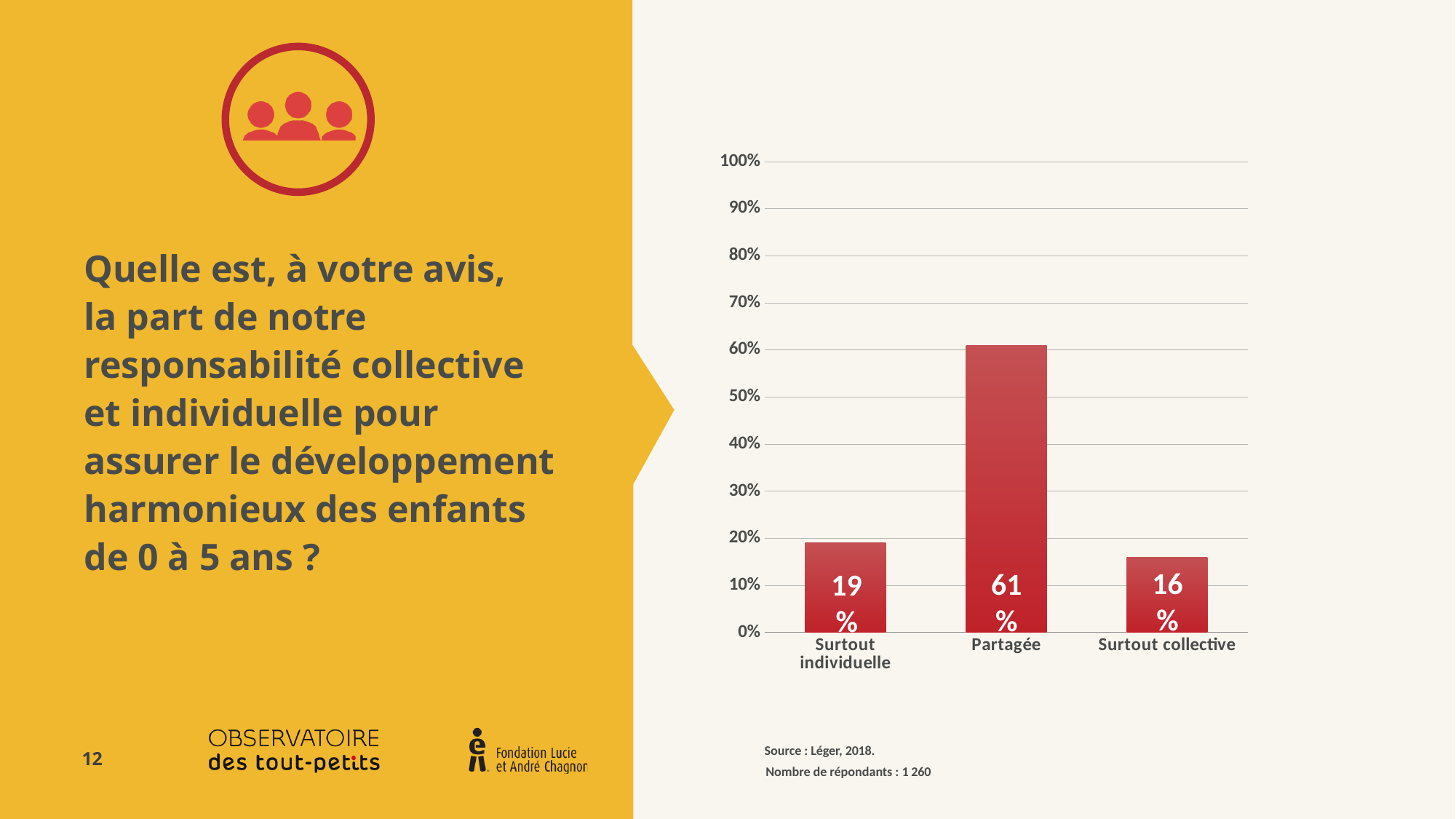
What is the value for Surtout individuelle? 19% Is the value for Partagée greater or less than 50%? greater Which category has the highest value? Partagée What is the difference between the values for Partagée and Surtout individuelle? 42% What is the value for Surtout collective? 16% What kind of chart is shown on the slide? bar chart What is the value for Partagée? 61% Which category has the lowest value? Surtout collective How many categories are shown on the x axis? 3 What is the number of respondents stated below the chart? 1 260 What is the difference between the values for Surtout individuelle and Surtout collective? 3% Which is larger, the value for Surtout individuelle or the value for Surtout collective? Surtout individuelle